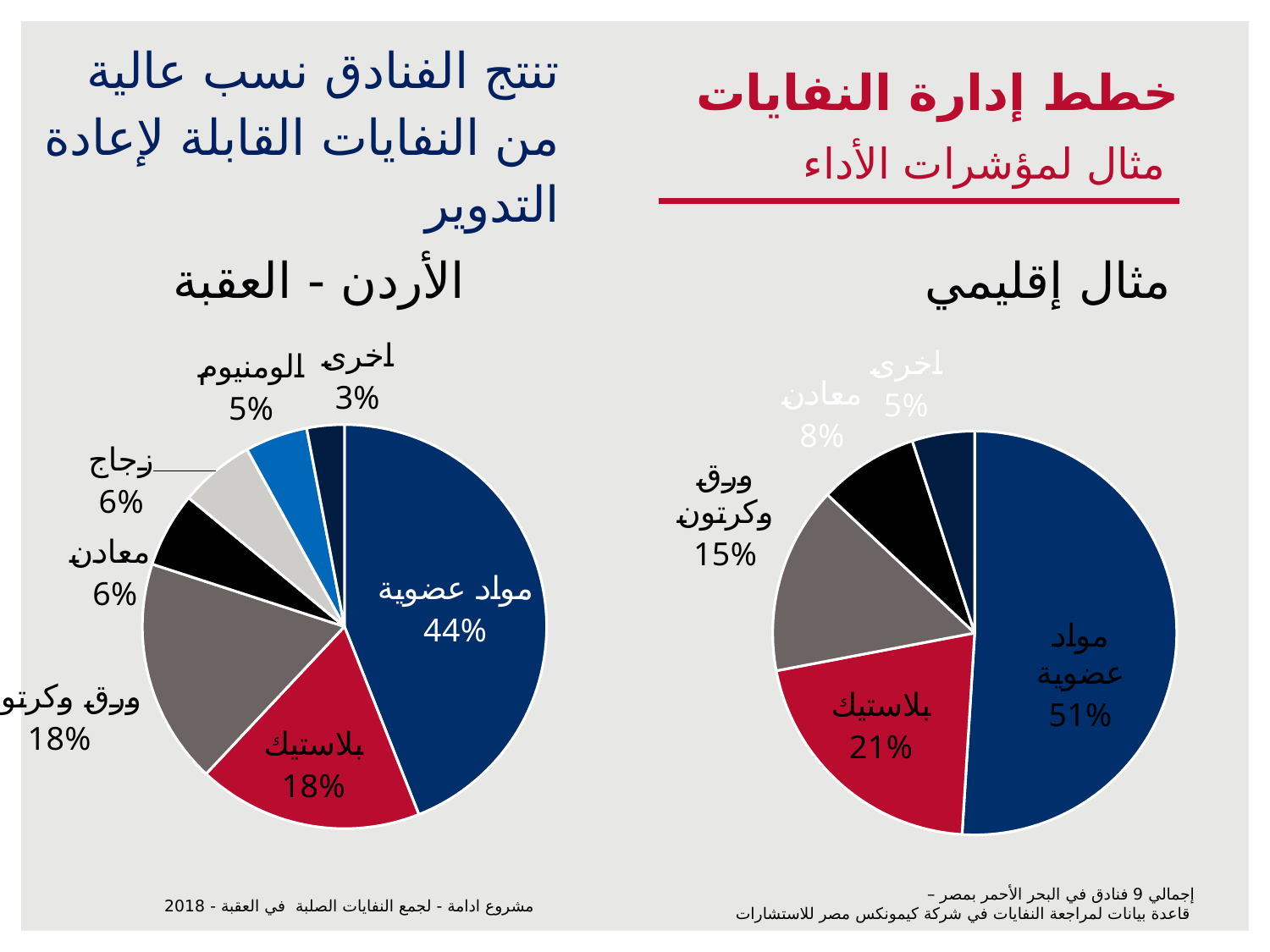
In the 'مثال إقليمي' pie chart, what is the difference between the shares of 'بلاستيك' and 'معادن'? 13% In the 'الأردن - العقبة' pie chart, which category has the smallest share? اخرى Which is larger: the share of 'بلاستيك' in the 'مثال إقليمي' chart or in the 'الأردن - العقبة' chart? مثال إقليمي In the 'مثال إقليمي' pie chart, how many slices are there? 5 In the 'مثال إقليمي' pie chart, what share is shown for 'ورق وكرتون' (paper and cardboard)? 15% In the 'الأردن - العقبة' pie chart, how many slices are there? 7 What type of chart is used on the slide for the 'مثال إقليمي' (regional example) data? Pie chart In the 'الأردن - العقبة' pie chart, what share is shown for 'مواد عضوية' (organic materials)? 44% In the 'مثال إقليمي' pie chart, what share is shown for 'مواد عضوية' (organic materials)? 51% In the 'مثال إقليمي' pie chart, which category has the largest share? مواد عضوية In the 'مثال إقليمي' pie chart, which category has the smallest share? اخرى In the 'الأردن - العقبة' pie chart, what share is shown for 'الومنيوم' (aluminium)? 5%